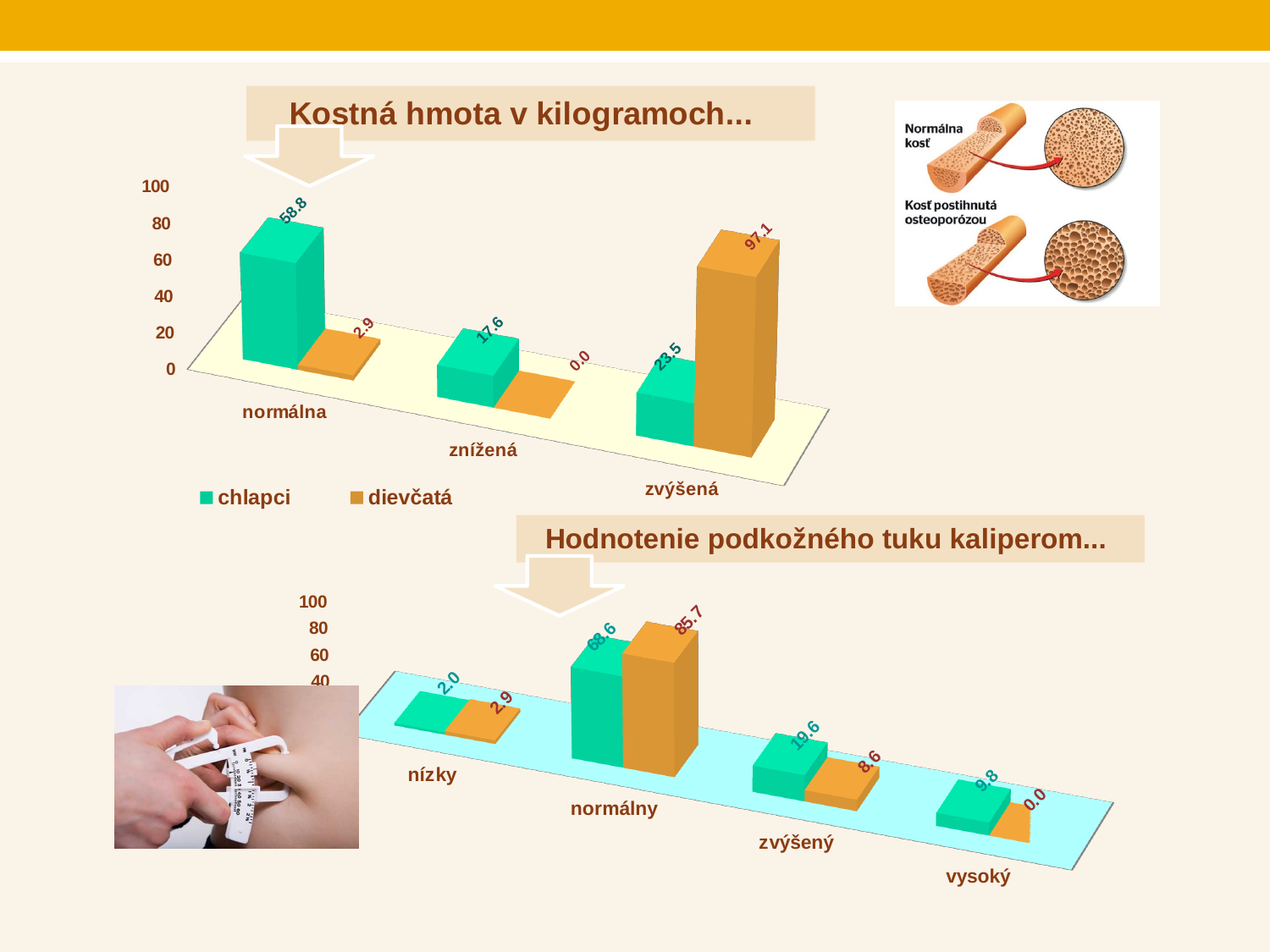
In the chart titled 'Kostná hmota v kilogramoch...', what is the value for dievčatá in the znížená category? 0.0 In the chart titled 'Hodnotenie podkožného tuku kaliperom...', how many categories are shown on the x axis? 4 In the chart titled 'Kostná hmota v kilogramoch...', what is the difference between the chlapci and dievčatá values in the zvýšená category? 73.6 In the chart titled 'Kostná hmota v kilogramoch...', what is the value for dievčatá in the zvýšená category? 97.1 In the chart titled 'Kostná hmota v kilogramoch...', how many series does the legend list? 2 In the chart titled 'Hodnotenie podkožného tuku kaliperom...', which is larger in the zvýšený category: the green bar or the orange bar? the green bar What kind of chart is the one titled 'Hodnotenie podkožného tuku kaliperom...'? bar chart In the chart titled 'Kostná hmota v kilogramoch...', what is the value for chlapci in the normálna category? 58.8 In the chart titled 'Hodnotenie podkožného tuku kaliperom...', what is the value of the green bar in the vysoký category? 9.8 In the chart titled 'Kostná hmota v kilogramoch...', how many categories are shown on the x axis? 3 In the chart titled 'Kostná hmota v kilogramoch...', which category has the highest value for chlapci? normálna In the chart titled 'Hodnotenie podkožného tuku kaliperom...', what is the value of the orange bar in the normálny category? 85.7